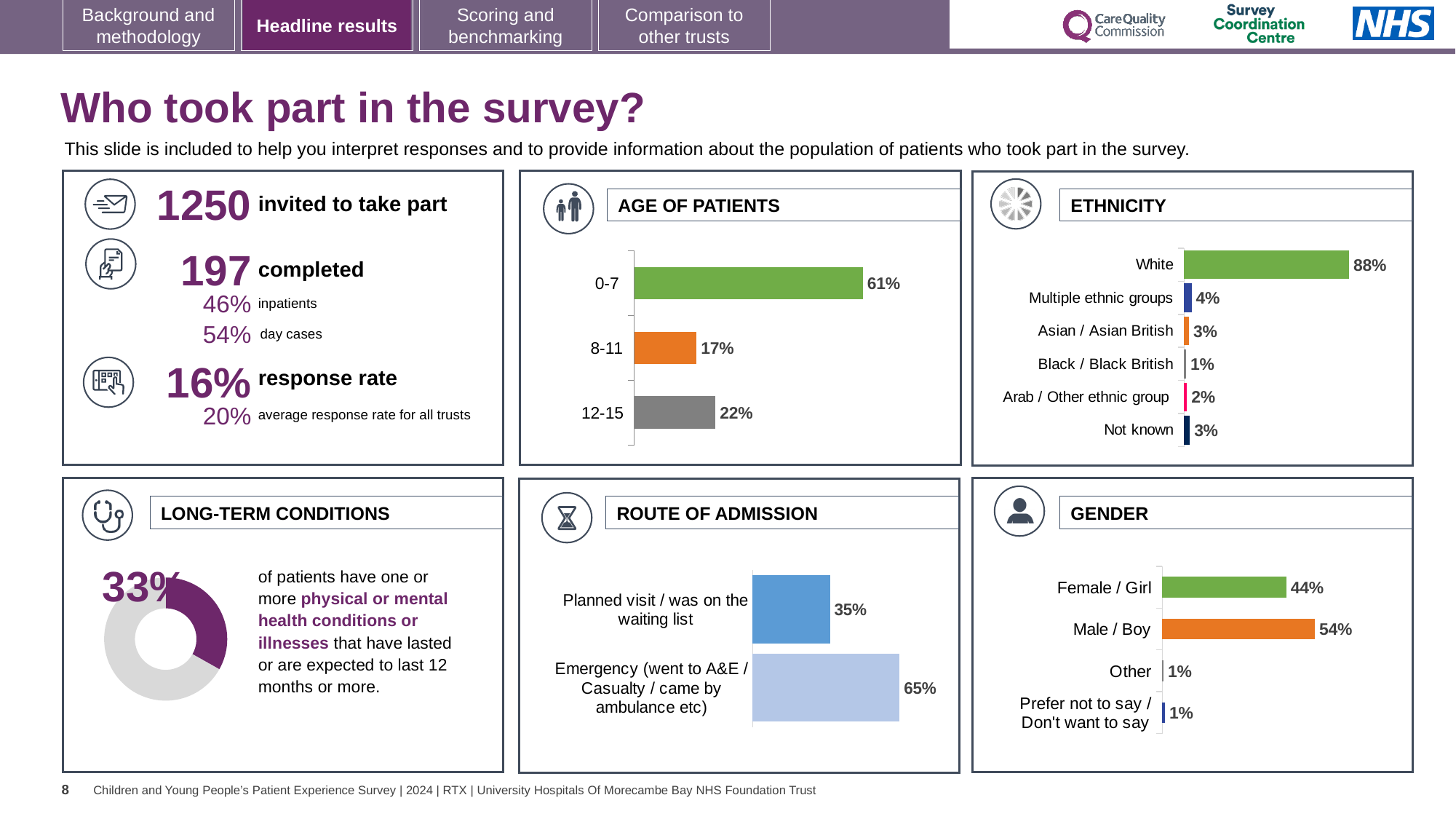
In the ETHNICITY chart, what percentage of patients were White? 88% How many categories are shown in the ETHNICITY chart? 6 In the LONG-TERM CONDITIONS chart, what percentage of patients have one or more long-term conditions? 33% In the AGE OF PATIENTS chart, what percentage of patients were aged 0-7? 61% In the AGE OF PATIENTS chart, which age group has the lowest percentage? 8-11 In the ETHNICITY chart, which category has the lowest percentage? Black / Black British In the GENDER chart, what is the difference between Male / Boy and Female / Girl? 10% In the ROUTE OF ADMISSION chart, what percentage of patients came via Emergency (went to A&E / Casualty / came by ambulance etc)? 65% In the AGE OF PATIENTS chart, what is the difference between the 12-15 and 8-11 percentages? 5% In the GENDER chart, what percentage of patients were Male / Boy? 54% What kind of chart is used in the LONG-TERM CONDITIONS panel? Donut chart In the ROUTE OF ADMISSION chart, which is larger: Planned visit / was on the waiting list or Emergency? Emergency (went to A&E / Casualty / came by ambulance etc)